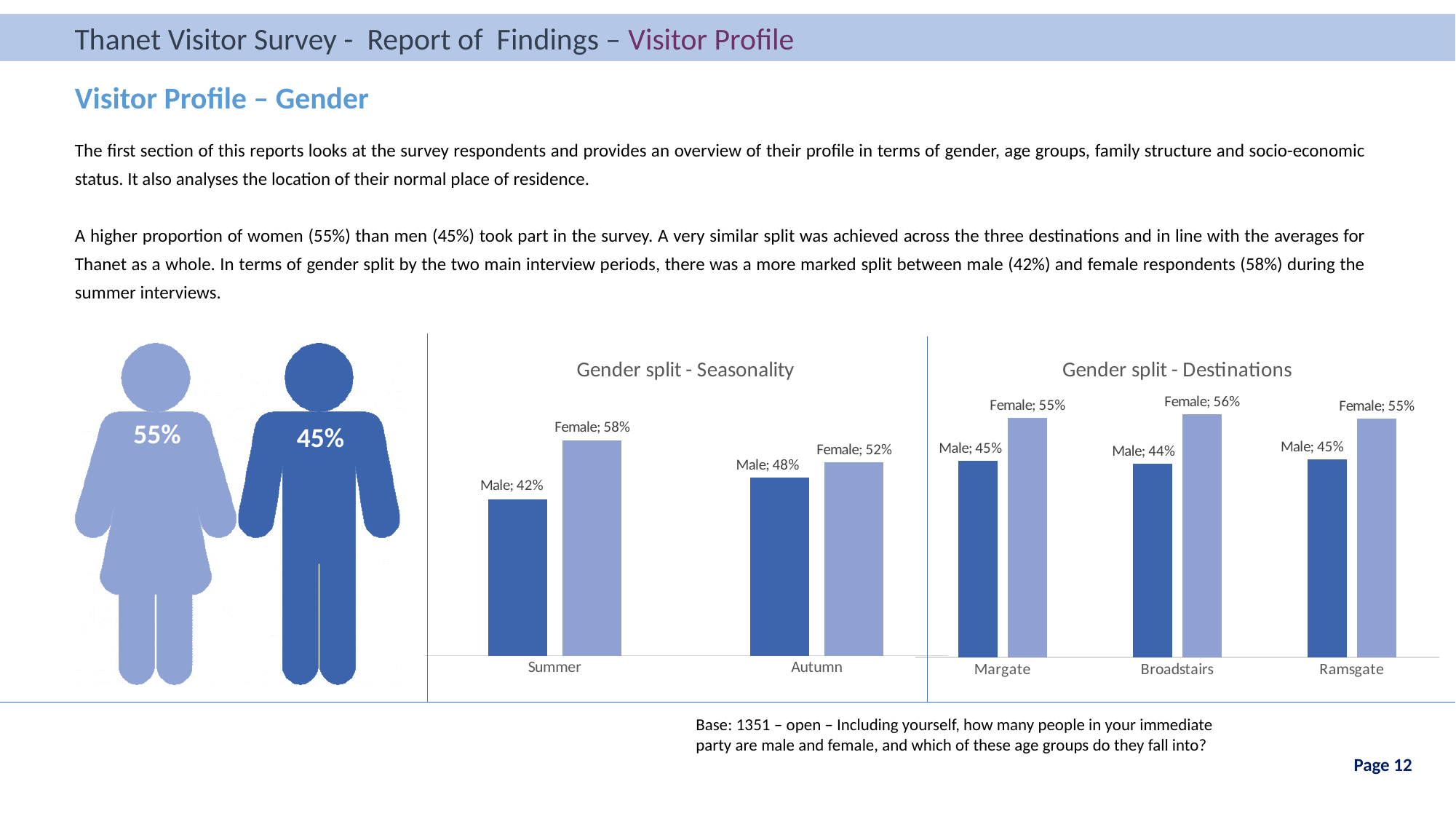
In the 'Gender split - Destinations' chart, how many destinations are shown? 3 In the 'Gender split - Destinations' chart, which destination has the lowest Male value? Broadstairs In the 'Gender split - Seasonality' chart, which season has the higher Male value? Autumn In the 'Gender split - Seasonality' chart, what is the Female value for Summer? 58% What type of chart is 'Gender split - Destinations'? Bar chart In the 'Gender split - Destinations' chart, what is the Male value for Margate? 45% In the 'Gender split - Destinations' chart, what is the Female value for Broadstairs? 56% In the 'Gender split - Seasonality' chart, what is the difference between the Female and Male values for Summer? 16% In the 'Gender split - Seasonality' chart, what is the Male value for Autumn? 48% In the 'Gender split - Destinations' chart, which destination has the highest Female value? Broadstairs In the 'Gender split - Seasonality' chart, how many categories are shown on the x axis? 2 In the 'Gender split - Destinations' chart, what is the difference between the Female and Male values for Ramsgate? 10%